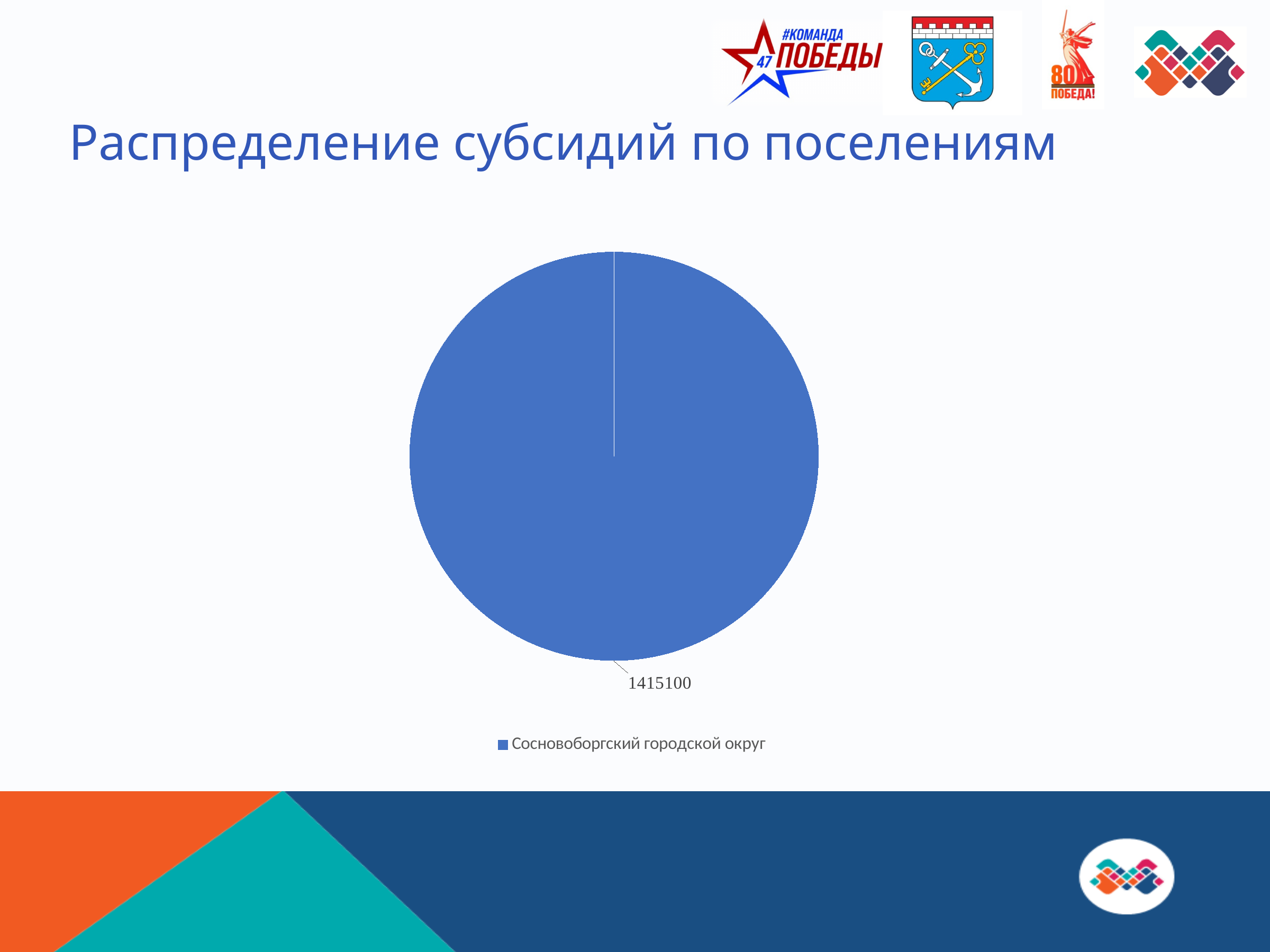
What category is listed in the chart legend? Сосновоборгский городской округ What share of the pie does the Сосновоборгский городской округ slice take? 100% Is the value for Сосновоборгский городской округ greater or less than 1000000? greater How many slices does the pie chart have? 1 What is the value shown for Сосновоборгский городской округ? 1415100 How many entries does the legend list? 1 What is the title of the slide containing the chart? Распределение субсидий по поселениям What kind of chart is shown on the slide? pie chart